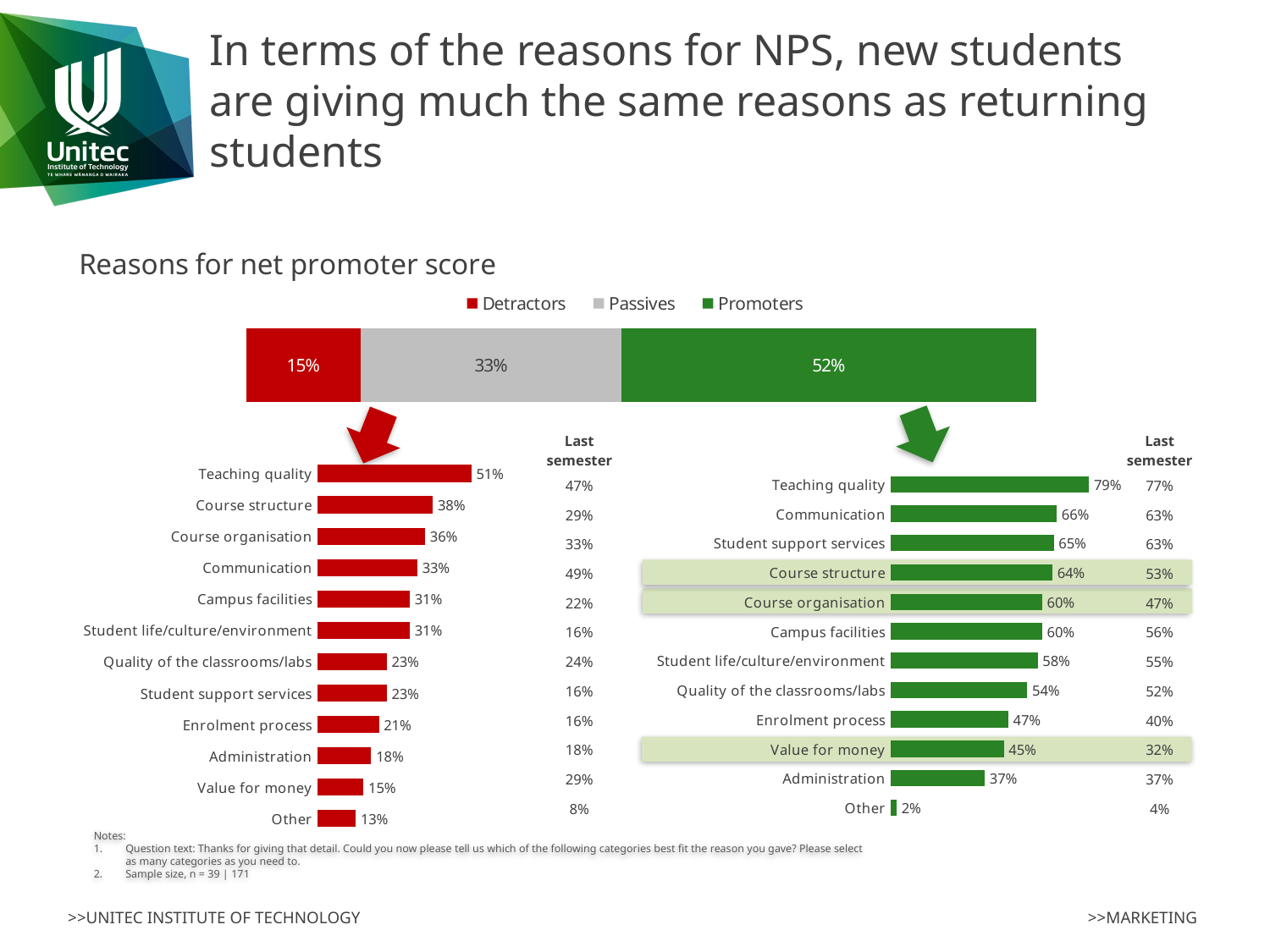
In the top stacked bar, what is the total of the Detractors, Passives and Promoters segments? 100% In the left red bar chart (Detractors), which category has the highest value? Teaching quality What kind of chart is the right green chart (Promoters)? Bar chart In the right green bar chart (Promoters), what is the difference between Teaching quality and Communication? 13% In the top stacked bar, what percentage are Promoters? 52% In the left red bar chart (Detractors), which category has the lowest value? Other In the right green bar chart (Promoters), what is the value for Value for money? 45% In the left red bar chart (Detractors), how many categories are shown? 12 In the left red bar chart (Detractors), what is the value for Course structure? 38% In the right green bar chart (Promoters), which is larger, Enrolment process or Administration? Enrolment process In the top stacked bar, what percentage are Passives? 33% How many series does the legend above the top stacked bar list? 3